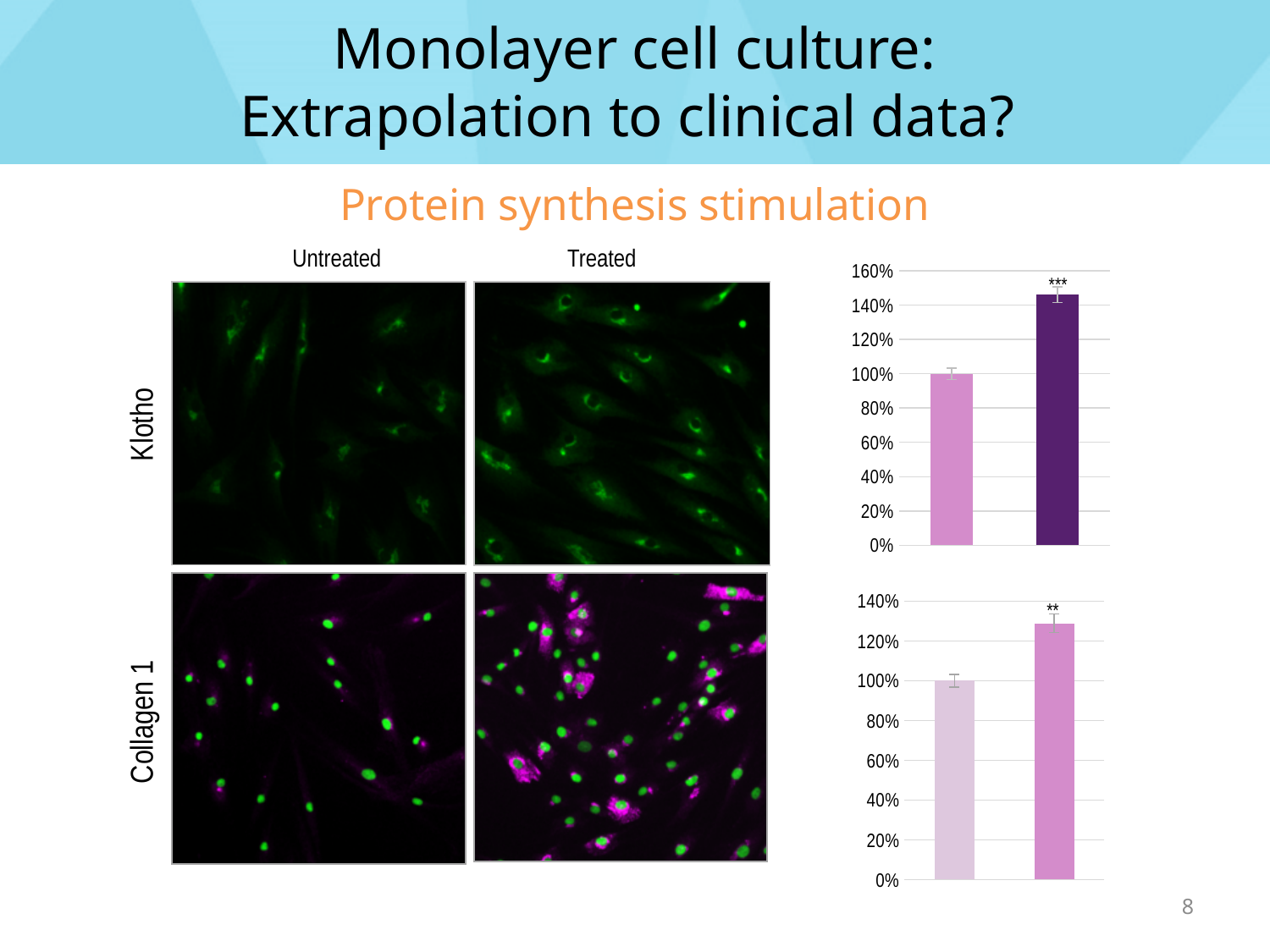
In the bottom chart on the right, which bar has the highest value? the right bar In the top chart on the right, is the value of the right bar greater or less than 140%? greater In the top chart on the right, which bar is taller, the left bar or the right bar? the right bar In the bottom chart on the right, is the value of the right bar greater or less than 120%? greater How many bars does the bottom chart on the right of the slide show? 2 What is the highest value shown on the y axis of the top chart on the right? 160% Do the bar values in the top chart on the right rise or fall from left to right? rise What kind of chart is the top chart on the right of the slide? bar chart In the bottom chart on the right, is the value of the right bar greater or less than 140%? less In the top chart on the right, what value does the left bar reach on the y axis? 100% What significance marker is printed above the right bar of the bottom chart on the right? ** In the bottom chart on the right, what value does the left bar reach on the y axis? 100%